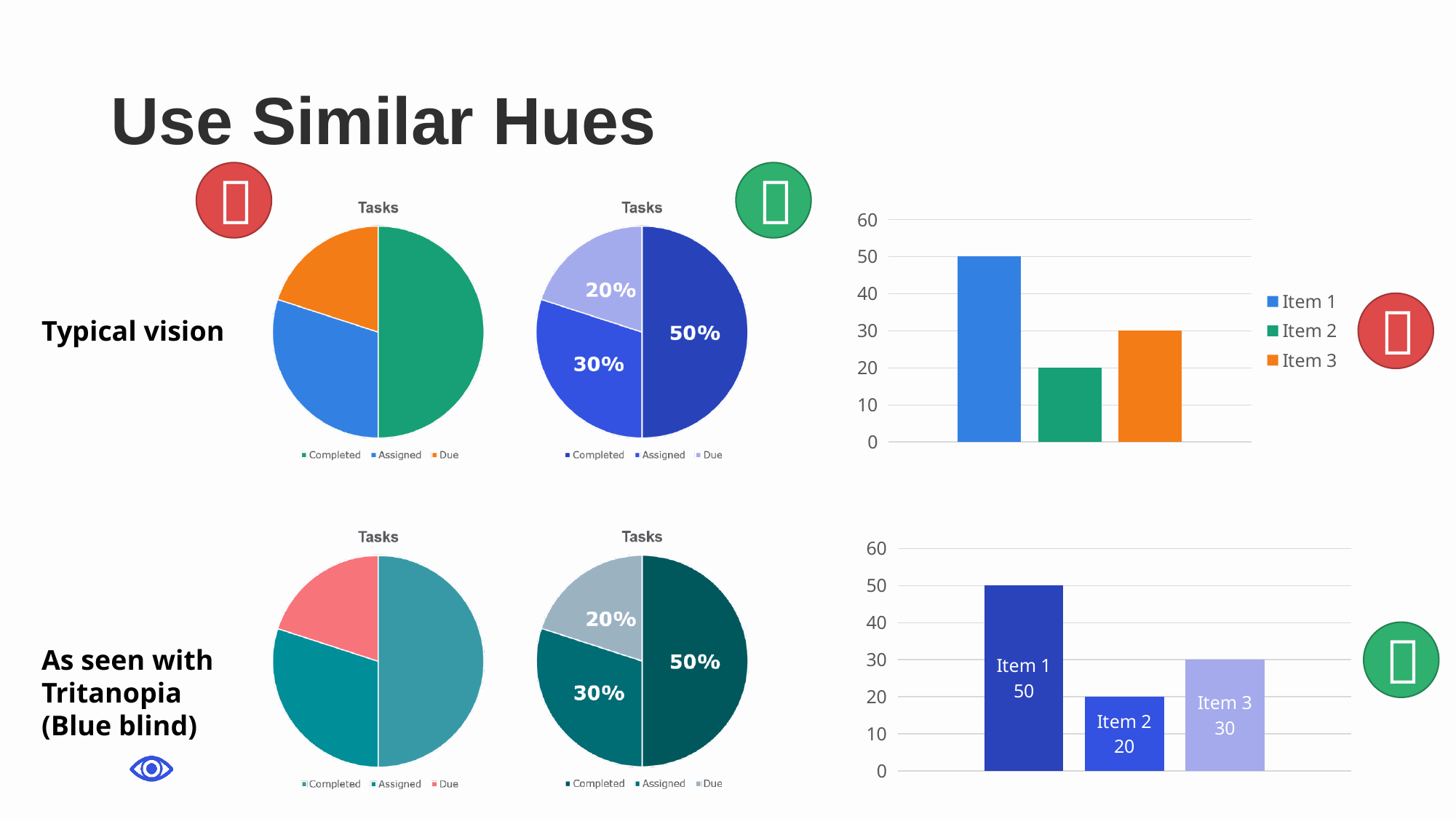
In the bottom-right bar chart, which item has the lowest value? Item 2 In the second pie chart in the top row, which is larger, the Assigned slice or the Due slice? Assigned In the bottom-right bar chart, what is the value for Item 3? 30 What type of chart is the chart in the top-right corner of the slide? Bar chart In the top-right bar chart, is the value for Item 3 greater or less than 40? less In the bottom-right bar chart, what is the value for Item 1? 50 In the top-right bar chart, which item has the highest bar? Item 1 In the second pie chart in the top row (titled Tasks, with percentage labels), what share does the Completed slice have? 50% How many series does the legend of the top-right bar chart list? 3 In the second pie chart in the bottom row (titled Tasks, with percentage labels), what share does the Due slice have? 20% In the bottom-right bar chart, what is the difference between the values for Item 1 and Item 3? 20 In the bottom-right bar chart, what is the value for Item 2? 20